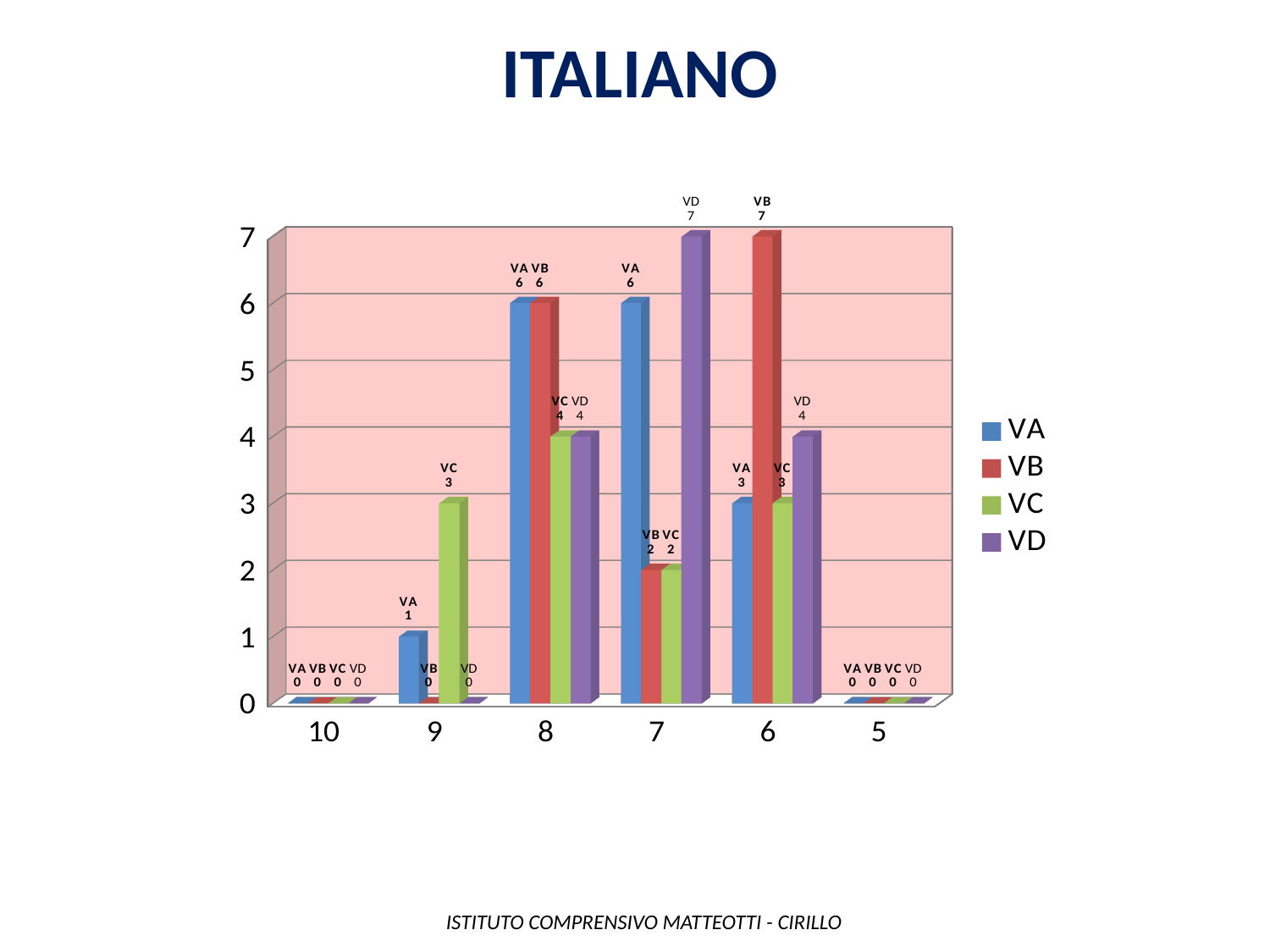
What is the value for VC at category 9? 3 How many categories are shown on the x axis? 6 What is the title of the chart? ITALIANO What kind of chart is shown? Bar chart Which category has the highest value for VA? 8 and 7 (both 6) What is the difference between VD and VB at category 7? 5 Which series has the lowest value at category 7? VB and VC (both 2) How many series does the legend list? 4 Which is larger at category 6: VB or VD? VB What is the value for VB at category 6? 7 What is the value for VA at category 8? 6 What is the value for VD at category 7? 7